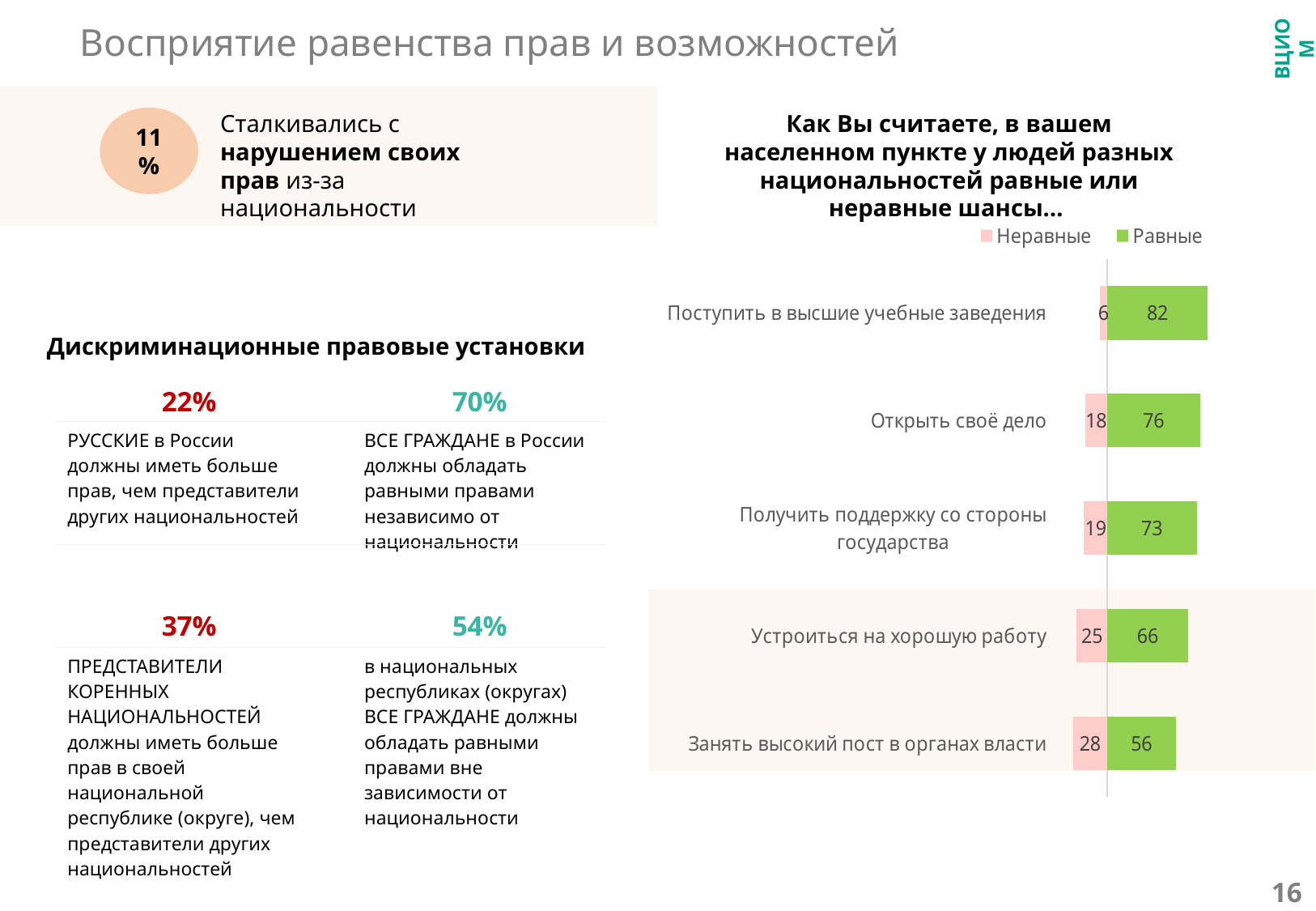
What kind of chart is shown on the slide? Bar chart How many categories are shown in the chart? 5 What is the difference between the "Равные" values for "Открыть своё дело" and "Устроиться на хорошую работу"? 10 What is the value for "Неравные" for "Открыть своё дело"? 18 What is the value for "Неравные" for "Занять высокий пост в органах власти"? 28 Which colour represents the "Равные" series in the chart? Green Which category has the highest value for "Равные"? Поступить в высшие учебные заведения Which category has the lowest value for "Неравные"? Поступить в высшие учебные заведения What is the total of "Неравные" and "Равные" for "Занять высокий пост в органах власти"? 84 What is the value for "Равные" for "Поступить в высшие учебные заведения"? 82 How many series does the chart legend list? 2 Which is larger: the "Неравные" value for "Устроиться на хорошую работу" or for "Получить поддержку со стороны государства"? Устроиться на хорошую работу